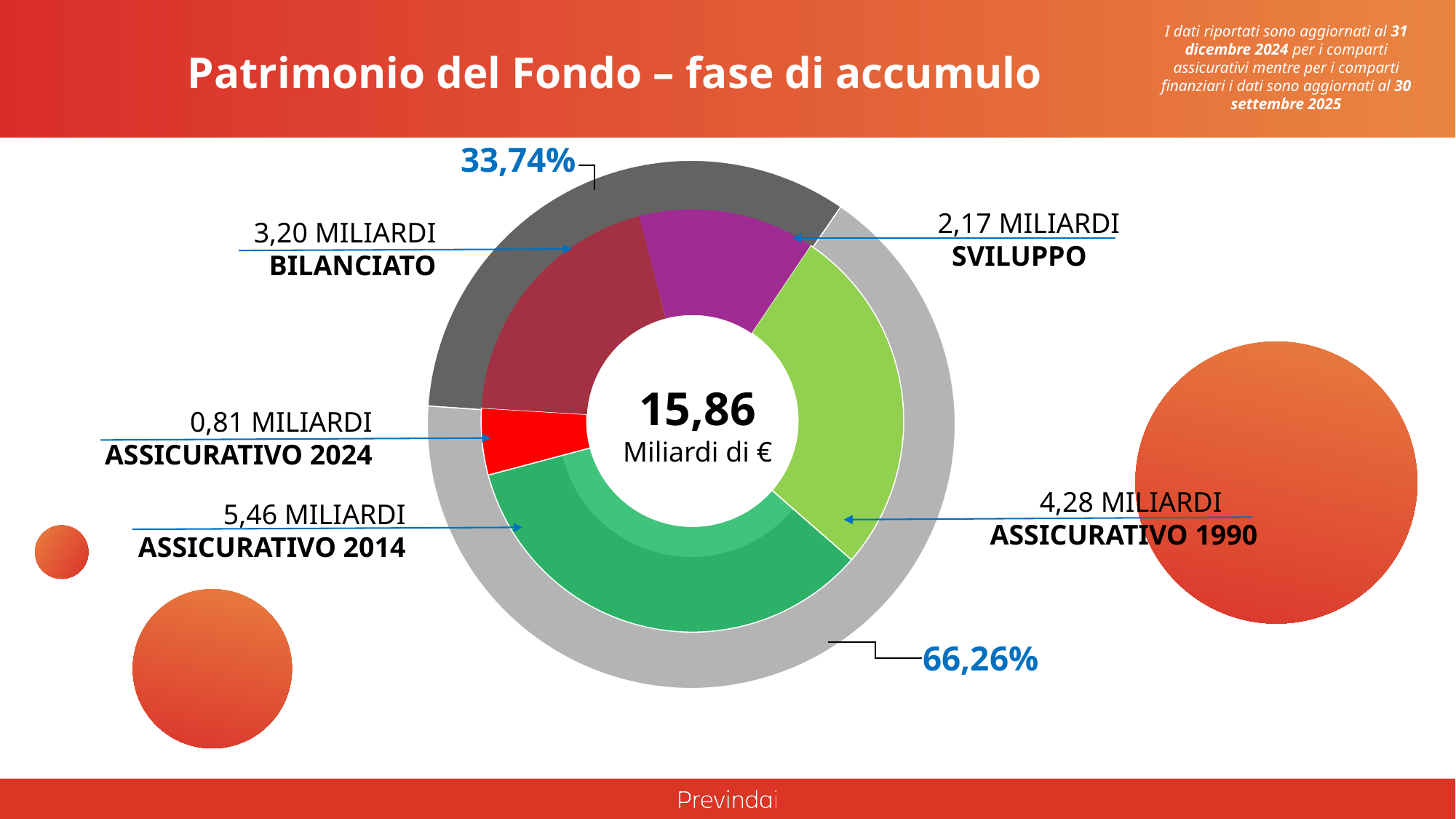
What is the difference between Assicurativo 2014 and Assicurativo 1990? 1,18 miliardi What is the value shown for Bilanciato? 3,20 miliardi Which comparto has the smallest value? Assicurativo 2024 What is the value shown for Sviluppo? 2,17 miliardi Which comparto has the largest value? Assicurativo 2014 What is the value shown for Assicurativo 2024? 0,81 miliardi What is the value shown for Assicurativo 2014? 5,46 miliardi What total value is shown in the centre of the chart? 15,86 Miliardi di € What percentage is shown for the outer ring segment covering Bilanciato and Sviluppo? 33,74% How many comparti are shown in the chart? 5 Which is larger, Bilanciato or Sviluppo? Bilanciato What kind of chart is shown on the slide? Donut chart